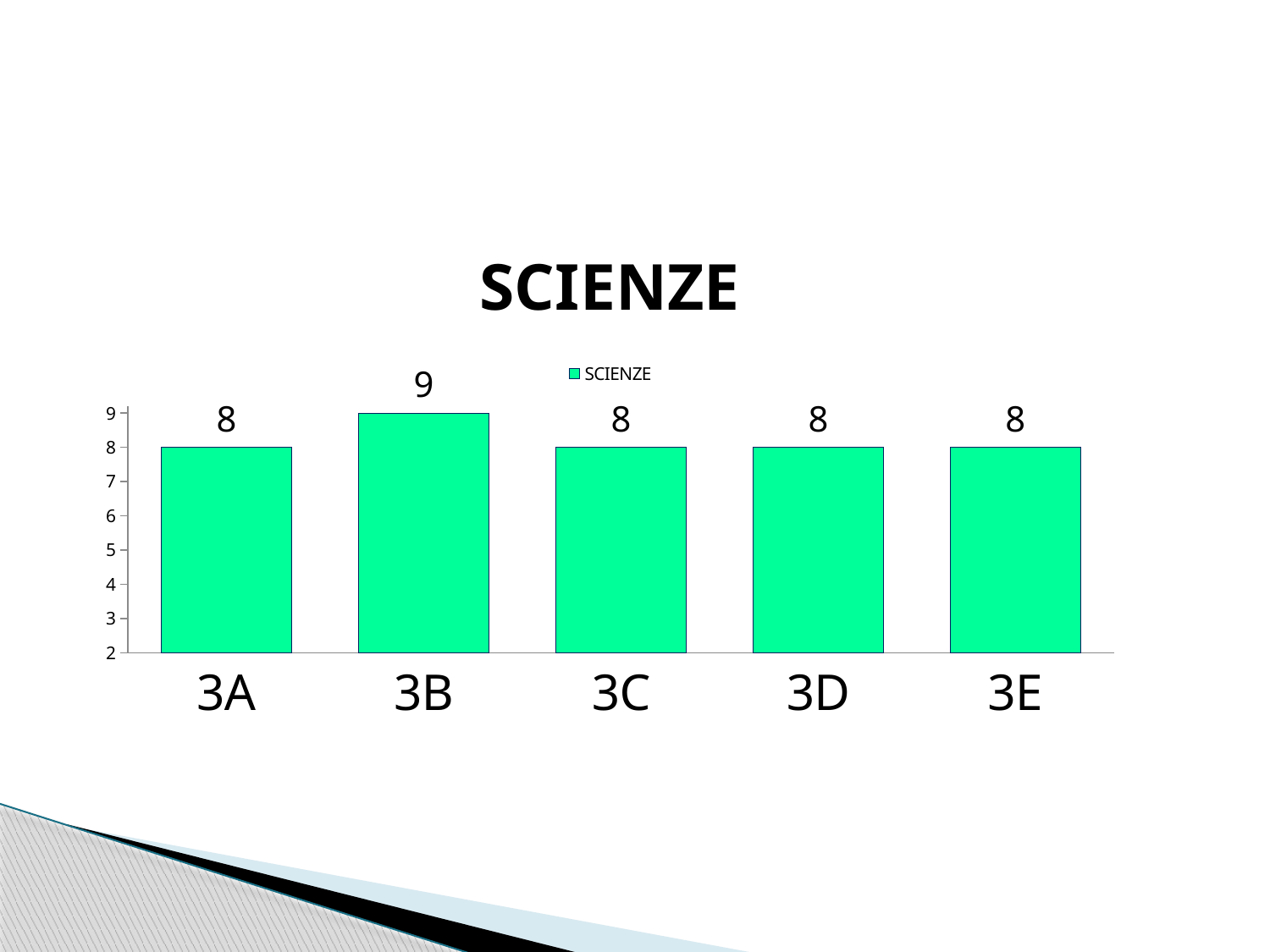
What is the lowest value shown on the y axis? 2 What is the title of the chart? SCIENZE Is the value for 3B greater or less than 5? greater What kind of chart is shown? bar chart Which category has the highest value? 3B How many categories are shown on the x axis? 5 What is the value for 3B? 9 What is the value for 3A? 8 What is the value for 3D? 8 How many series does the legend list? 1 Which is larger, the value for 3B or the value for 3E? 3B What is the difference between the values for 3B and 3C? 1